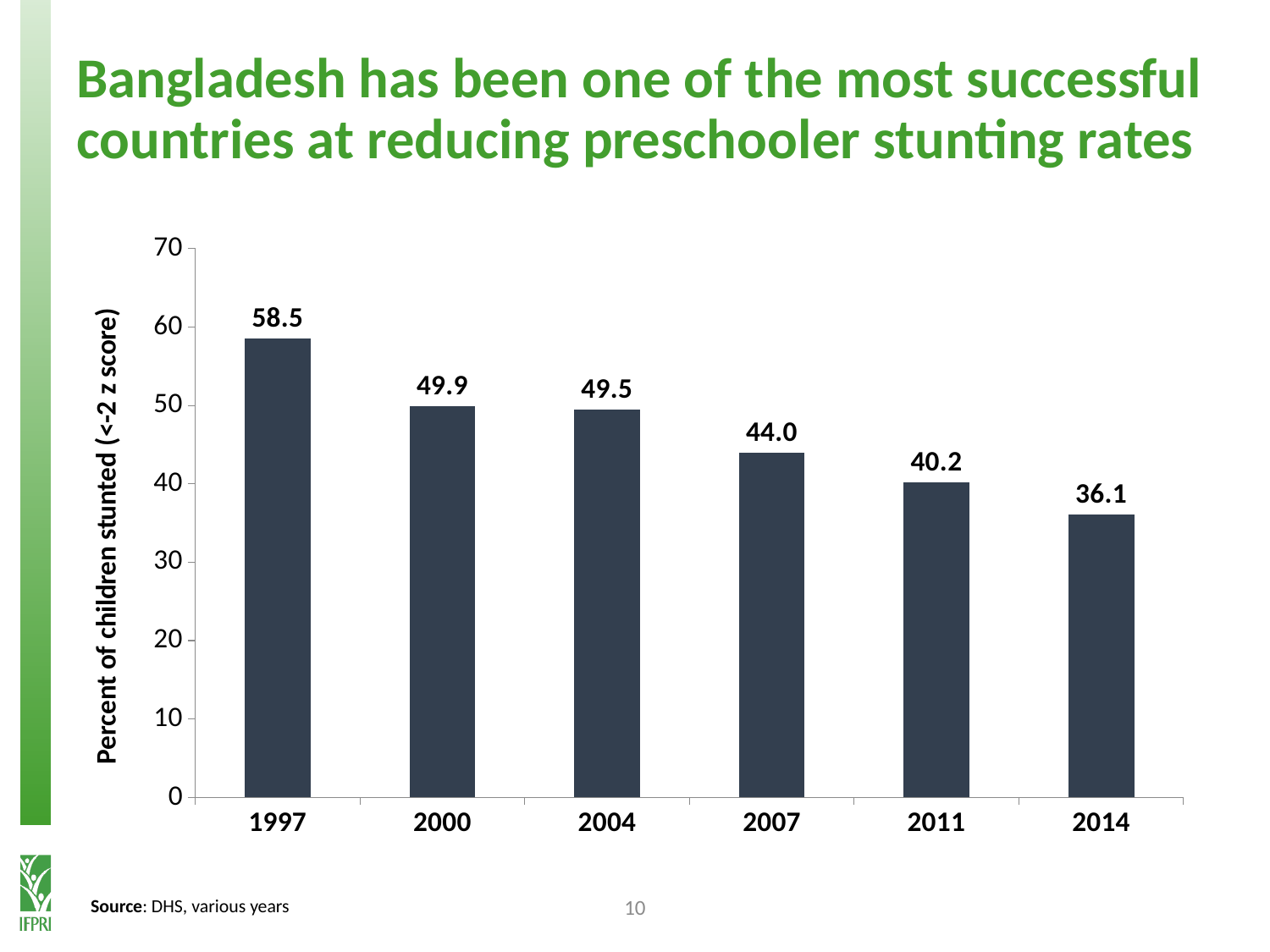
Which year has the highest stunting rate? 1997 Is the value for 2011 greater or less than 50? less What is the difference between the stunting rate in 2007 and in 2011? 3.8 What is the percent of children stunted in 2014? 36.1 Which year has the lowest stunting rate? 2014 What kind of chart is shown on the slide? Bar chart What is the percent of children stunted in 1997? 58.5 What is the difference between the stunting rate in 1997 and in 2014? 22.4 Which year has a higher stunting rate, 2000 or 2011? 2000 Do the stunting rates rise or fall from 1997 to 2014? Fall How many years are shown on the chart? 6 What is the percent of children stunted in 2007? 44.0